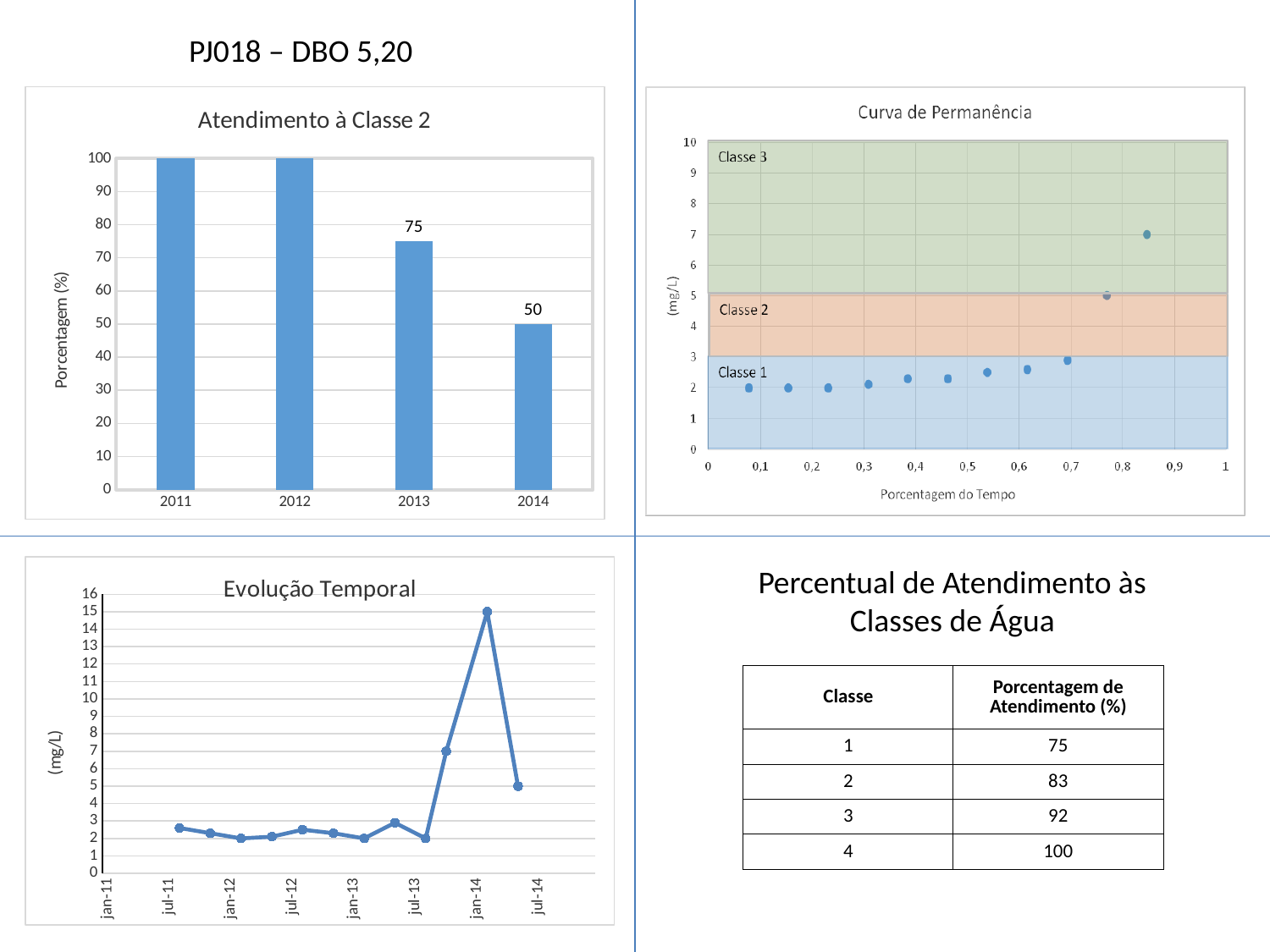
In the 'Evolução Temporal' chart, what is the highest value reached by the line? 15 What kind of chart is 'Evolução Temporal'? line chart In the 'Evolução Temporal' chart, is the value at jul-12 greater or less than 5? less In the 'Atendimento à Classe 2' chart, what is the difference between the values for 2013 and 2014? 25 In the 'Atendimento à Classe 2' chart, what is the value for 2011? 100 In the 'Atendimento à Classe 2' chart, what is the value for 2013? 75 In the 'Atendimento à Classe 2' chart, how many years are shown on the x axis? 4 What is the label of the y axis in the 'Curva de Permanência' chart? (mg/L) In the 'Atendimento à Classe 2' chart, which year has the lowest value? 2014 In the 'Atendimento à Classe 2' chart, do the values rise or fall from 2011 to 2014? fall In the 'Atendimento à Classe 2' chart, what is the value for 2014? 50 What kind of chart is 'Atendimento à Classe 2'? bar chart